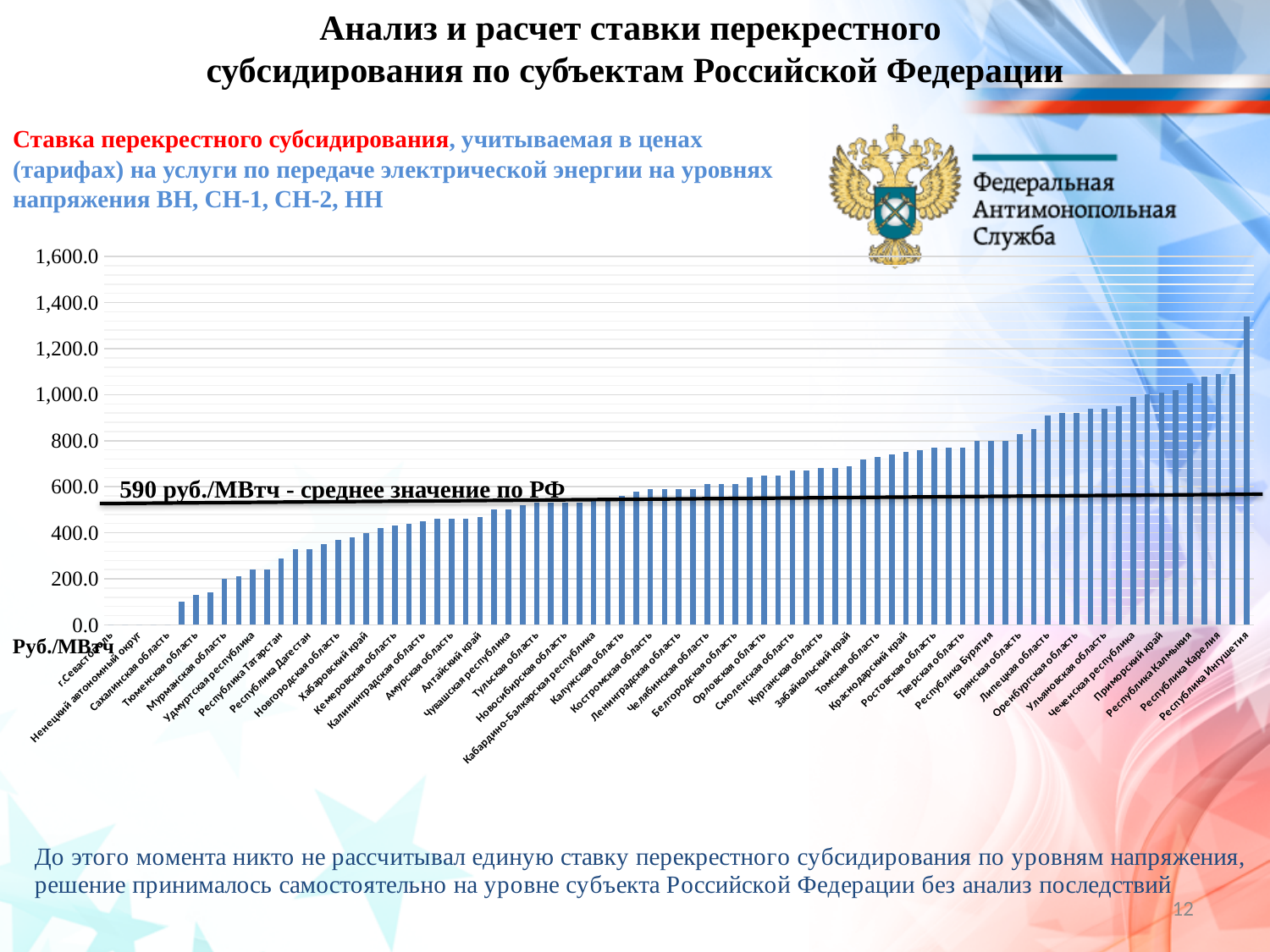
What average value for the Russian Federation is marked by the horizontal line on the chart? 590 руб./МВтч Which has the larger value, Томская область or Республика Татарстан? Томская область Is the value for Томская область greater or less than 600? greater Is the value for Республика Карелия greater or less than 1,000? greater Which region has the highest cross-subsidy rate in the chart? Республика Ингушетия Is the value for Республика Ингушетия greater or less than 1,200? greater Do the bar values rise or fall from left to right along the x axis? rise What unit is shown for the vertical axis of the chart? Руб./МВтч What kind of chart is shown on the slide? bar chart Which has the larger value, Республика Ингушетия or Тюменская область? Республика Ингушетия